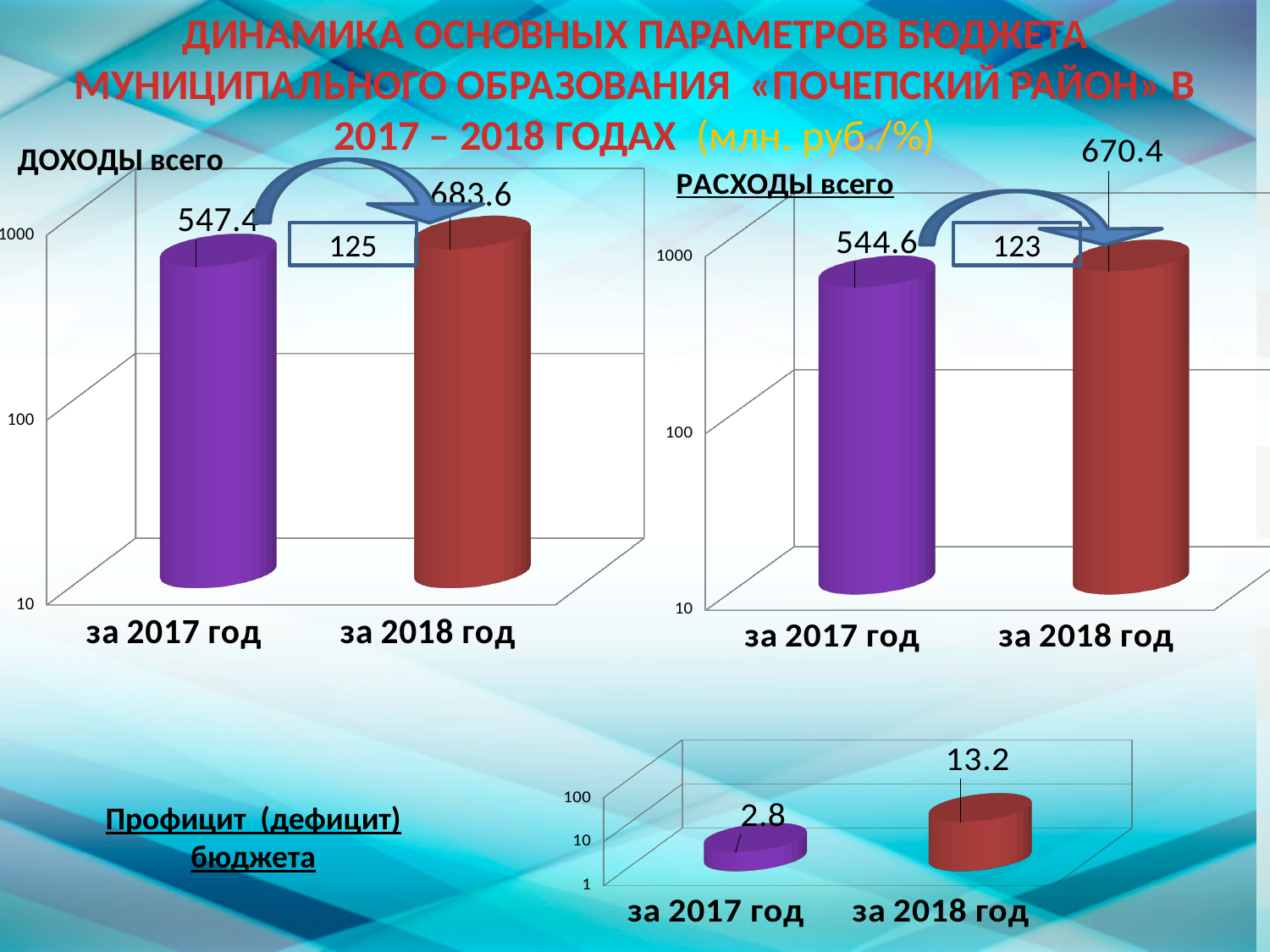
In the 'ДОХОДЫ всего' chart, what is the difference between the 2018 and 2017 values? 136.2 In the 'РАСХОДЫ всего' chart, what is the value for 'за 2017 год'? 544.6 In the 'ДОХОДЫ всего' chart, do the values rise or fall from 2017 to 2018? rise What kind of chart is the 'РАСХОДЫ всего' chart? bar chart How many categories are shown in the 'Профицит (дефицит) бюджета' chart? 2 In the 'ДОХОДЫ всего' chart, what is the value for 'за 2018 год'? 683.6 In the 'РАСХОДЫ всего' chart, which year has the higher value? за 2018 год In the 'Профицит (дефицит) бюджета' chart, what is the value for 'за 2018 год'? 13.2 In the 'Профицит (дефицит) бюджета' chart, which year has the lower value? за 2017 год In the 'Профицит (дефицит) бюджета' chart, what is the value for 'за 2017 год'? 2.8 In the 'РАСХОДЫ всего' chart, what is the value for 'за 2018 год'? 670.4 In the 'ДОХОДЫ всего' chart, what is the value for 'за 2017 год'? 547.4